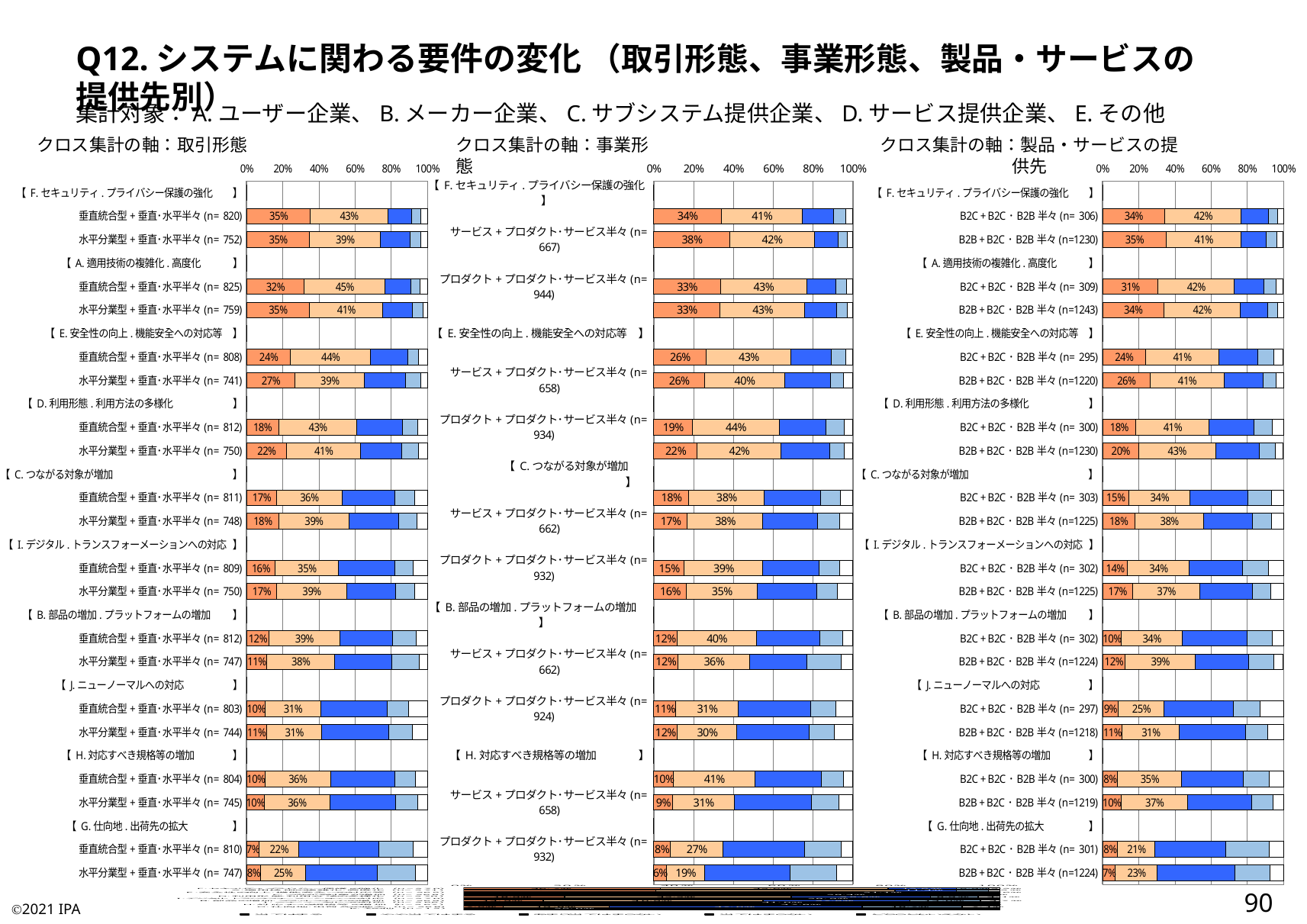
What type of chart is used on this slide? Stacked horizontal bar chart In the left chart (取引形態), what is the value of the second segment for 垂直統合型＋垂直・水平半々 (n=825) under A. 適用技術の複雑化・高度化? 45% In the left chart (取引形態), what is the difference between the leftmost segment values of 垂直統合型 (n=808) and 水平分業型 (n=741) under E. 安全性の向上・機能安全への対応等? 3% In the right chart (製品・サービスの提供先), what is the value of the leftmost segment for B2B＋B2C・B2B半々 (n=1230) under F. セキュリティ・プライバシー保護の強化? 35% In the right chart (製品・サービスの提供先), what is the value of the leftmost segment for B2C＋B2C・B2B半々 (n=297) under J. ニューノーマルへの対応? 9% In the right chart (製品・サービスの提供先), what is the value of the second segment for B2C＋B2C・B2B半々 (n=303) under C. つながる対象が増加? 34% How many charts are shown on the slide? 3 In the middle chart (事業形態), what is the value of the leftmost segment of the second bar under F. セキュリティ・プライバシー保護の強化? 38% In the right chart (製品・サービスの提供先), which has the larger leftmost segment under D. 利用形態・利用方法の多様化: B2C＋B2C・B2B半々 (n=300) or B2B＋B2C・B2B半々 (n=1230)? B2B＋B2C・B2B半々 (n=1230) In the left chart (取引形態), what is the value of the leftmost segment for 垂直統合型＋垂直・水平半々 (n=820) under F. セキュリティ・プライバシー保護の強化? 35% In the left chart (取引形態), what is the combined value of the first two segments for 垂直統合型＋垂直・水平半々 (n=810) under G. 仕向地・出荷先の拡大? 29% In the left chart (取引形態), what is the value of the leftmost segment for 水平分業型＋垂直・水平半々 (n=747) under G. 仕向地・出荷先の拡大? 8%